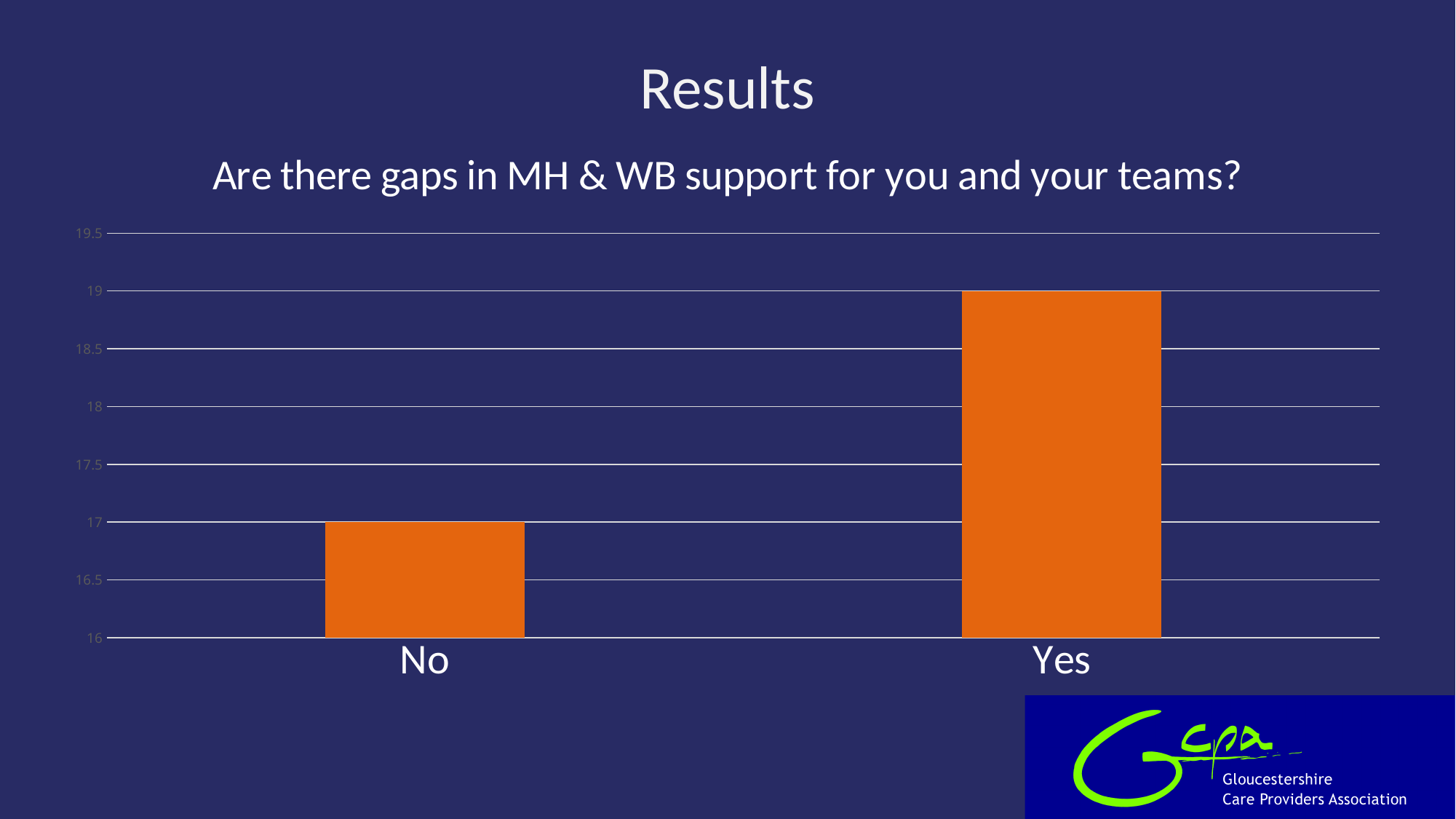
What is the difference between the values for "Yes" and "No"? 2 What is the value for "Yes" in the chart? 19 What colour are the bars in the chart? orange What question does the chart title ask? Are there gaps in MH & WB support for you and your teams? Which category has the lowest value in the chart? No What is the value for "No" in the chart? 17 Is the value for "No" greater or less than 18? less Is the value for "Yes" greater or less than 18.5? greater How many categories are shown on the x axis of the chart? 2 Which is larger, the value for "Yes" or the value for "No"? Yes Which category has the highest value in the chart? Yes What type of chart is shown on the slide? bar chart